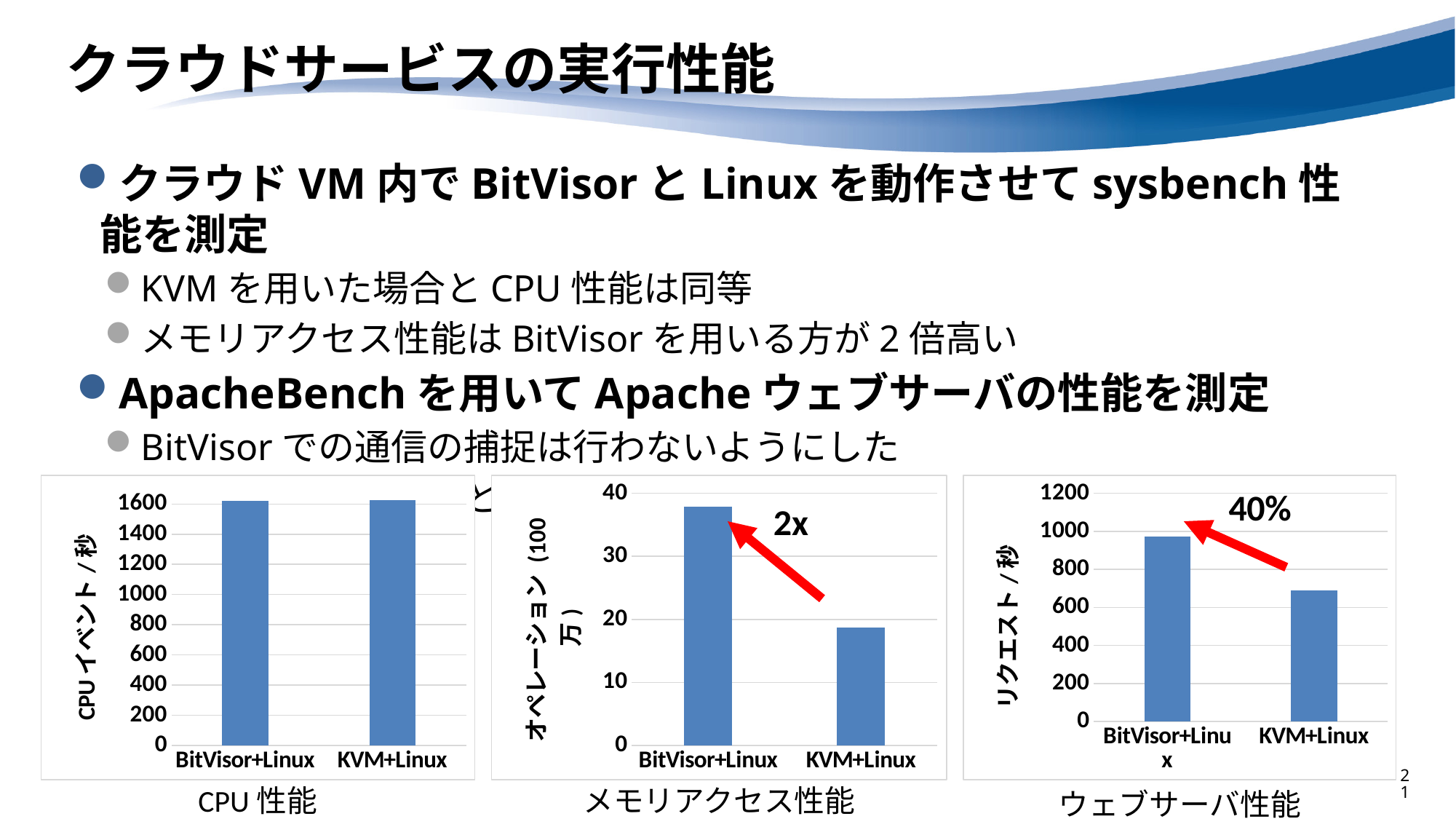
In the ウェブサーバ性能 chart on the right, is the value for KVM+Linux greater or less than 800? less In the メモリアクセス性能 chart in the middle, which category has the highest value? BitVisor+Linux What kind of chart is the CPU 性能 chart on the left? bar chart In the メモリアクセス性能 chart in the middle, is the value for KVM+Linux greater or less than 20? less What annotation text is shown next to the red arrow in the メモリアクセス性能 chart in the middle? 2x What is the y-axis label of the ウェブサーバ性能 chart on the right? リクエスト / 秒 In the ウェブサーバ性能 chart on the right, which is larger, BitVisor+Linux or KVM+Linux? BitVisor+Linux In the CPU 性能 chart on the left, is the value for KVM+Linux greater or less than 1400? greater In the ウェブサーバ性能 chart on the right, which category has the lowest value? KVM+Linux How many categories are shown in the メモリアクセス性能 chart in the middle? 2